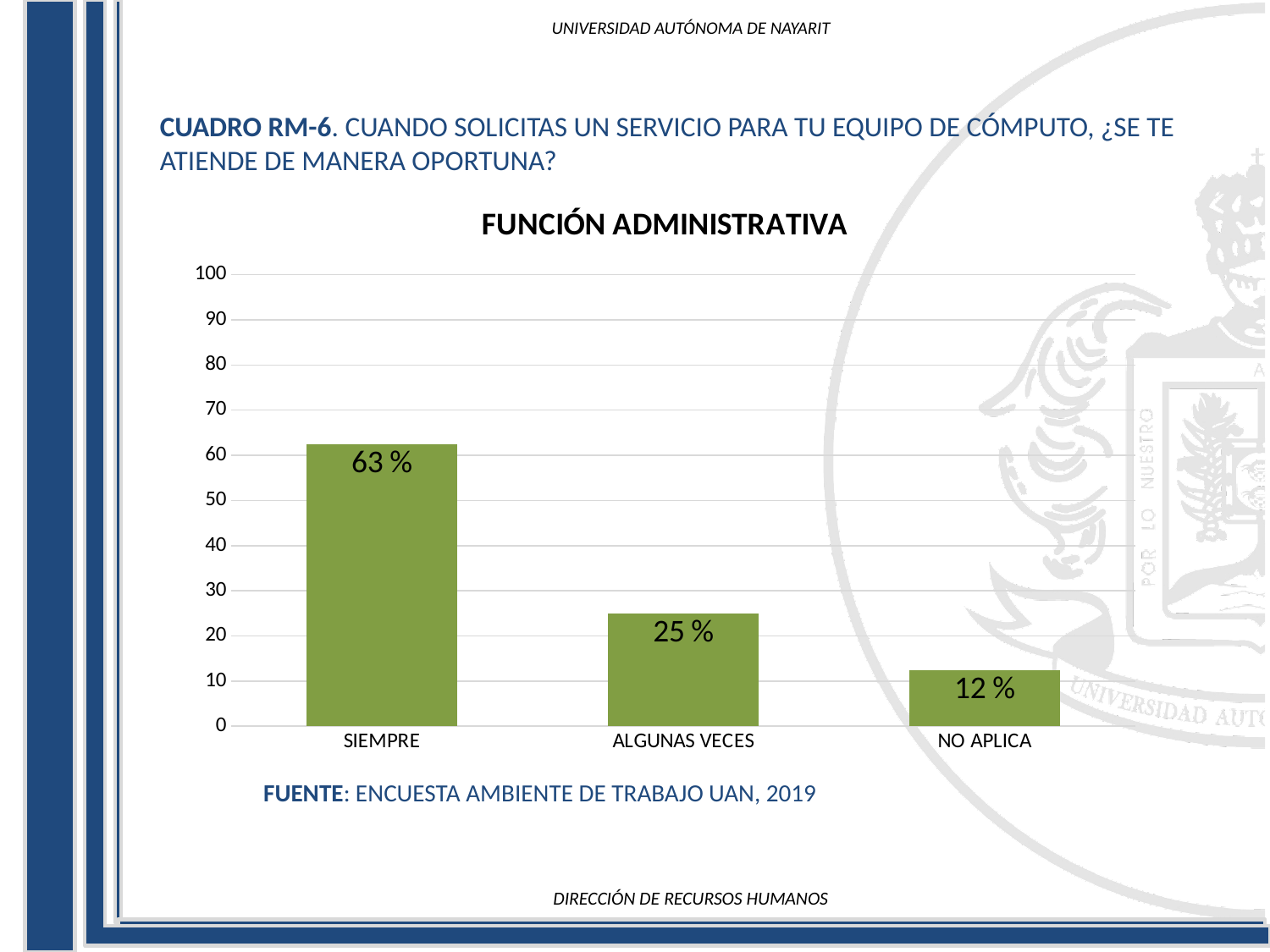
What is the difference between the values for ALGUNAS VECES and NO APLICA? 13 % Which category has the highest value? SIEMPRE What is the title of the chart? FUNCIÓN ADMINISTRATIVA What is the difference between the values for SIEMPRE and ALGUNAS VECES? 38 % How many categories are shown on the x axis? 3 What is the value for NO APLICA? 12 % Is the value for SIEMPRE greater or less than 50? greater What is the value for ALGUNAS VECES? 25 % What kind of chart is shown on the slide? bar chart Which category has the lowest value? NO APLICA What is the value for SIEMPRE? 63 % Which is larger, the value for ALGUNAS VECES or the value for NO APLICA? ALGUNAS VECES